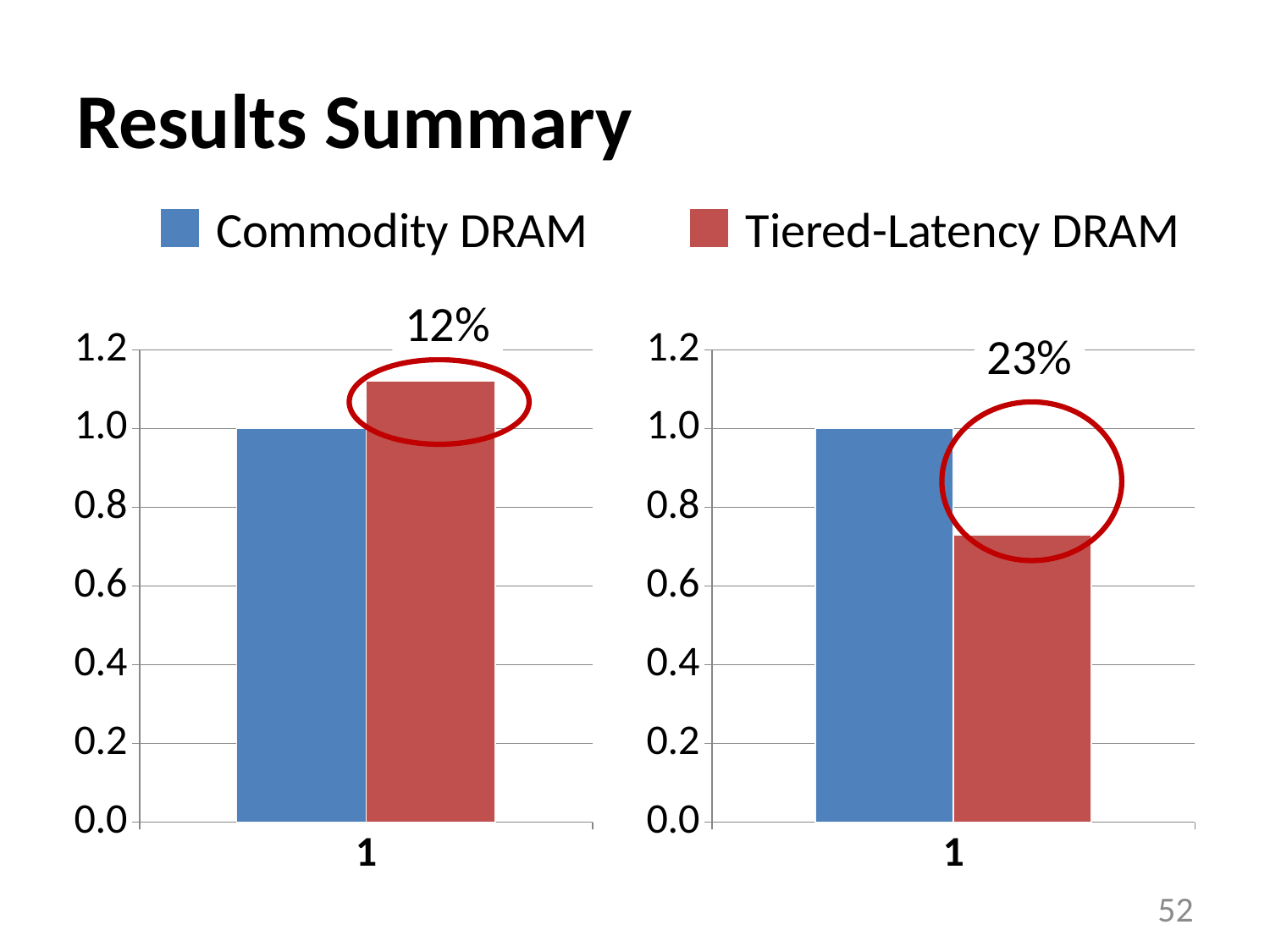
In the left chart, which series has the higher value, Commodity DRAM or Tiered-Latency DRAM? Tiered-Latency DRAM Which series is shown in blue in the legend? Commodity DRAM In the right chart, is the value for Tiered-Latency DRAM greater or less than 0.8? less What percentage is annotated above the circled bar in the left chart? 12% What percentage is annotated above the circled area in the right chart? 23% Which series is shown in red in the legend? Tiered-Latency DRAM In the left chart, what is the value for Commodity DRAM? 1.0 In the left chart, is the value for Tiered-Latency DRAM greater or less than 1.0? greater How many series does the legend list? 2 What kind of chart is the left chart on the slide? bar chart In the right chart, what is the value for Commodity DRAM? 1.0 In the right chart, which series has the lower value? Tiered-Latency DRAM